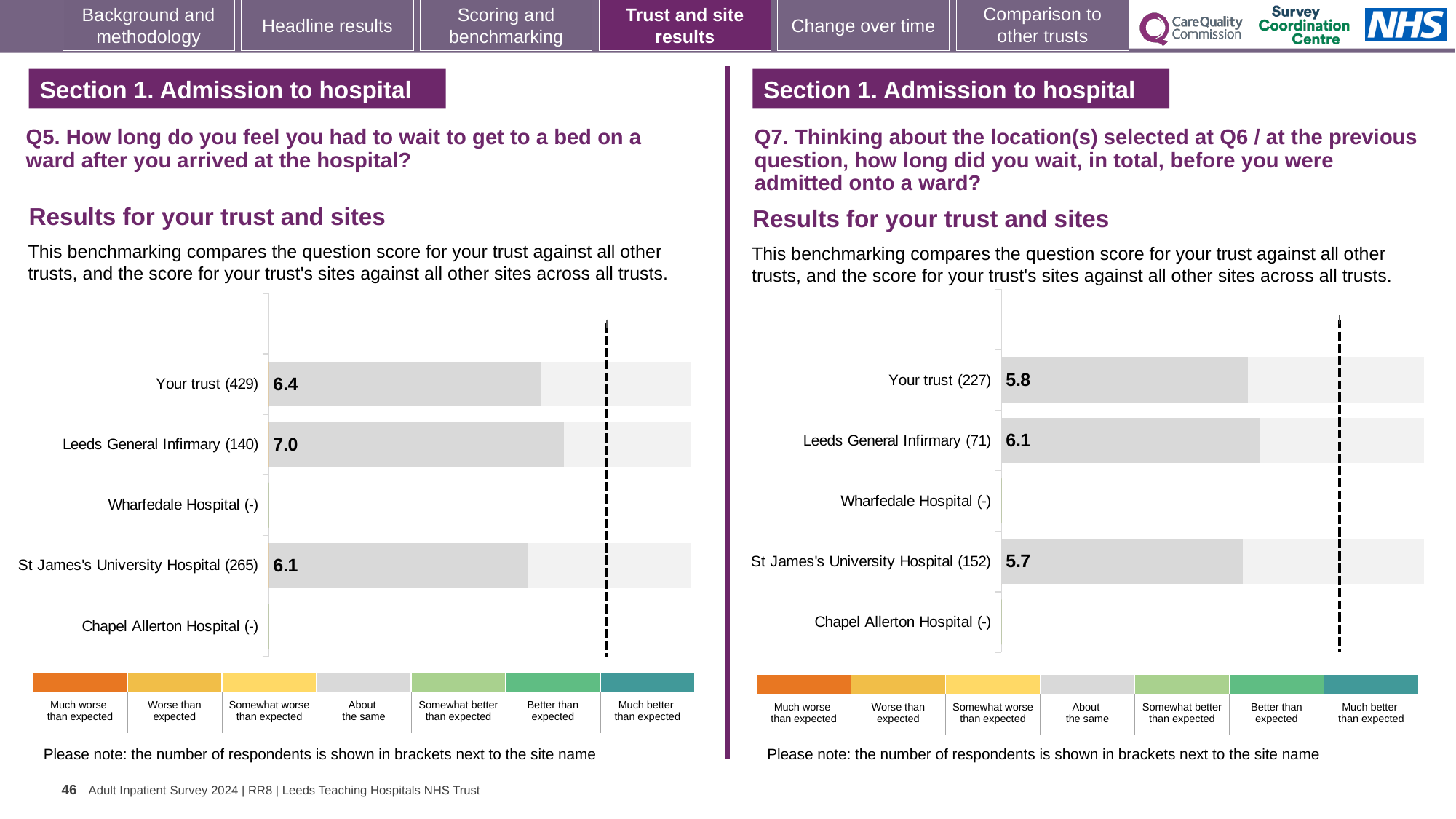
On the Q5 chart (left), which has the larger score, Your trust or St James's University Hospital? Your trust On the Q5 chart (left), what is the score for St James's University Hospital? 6.1 On the Q5 chart (left), what is the score for Leeds General Infirmary? 7.0 How many respondents are shown in brackets for Your trust on the Q7 chart (right)? 227 On the Q7 chart (right), what is the score for St James's University Hospital? 5.7 On the Q5 chart (left), which site or trust has the highest score? Leeds General Infirmary On the Q5 chart (left), what is the difference between the scores for Leeds General Infirmary and St James's University Hospital? 0.9 On the Q5 chart (left), what is the score for Your trust? 6.4 On the Q7 chart (right), which site or trust has the highest score? Leeds General Infirmary On the Q7 chart (right), what is the difference between the scores for Leeds General Infirmary and Your trust? 0.3 On the Q7 chart (right), what is the score for Your trust? 5.8 What kind of chart is used on the Q5 chart (left)? Bar chart